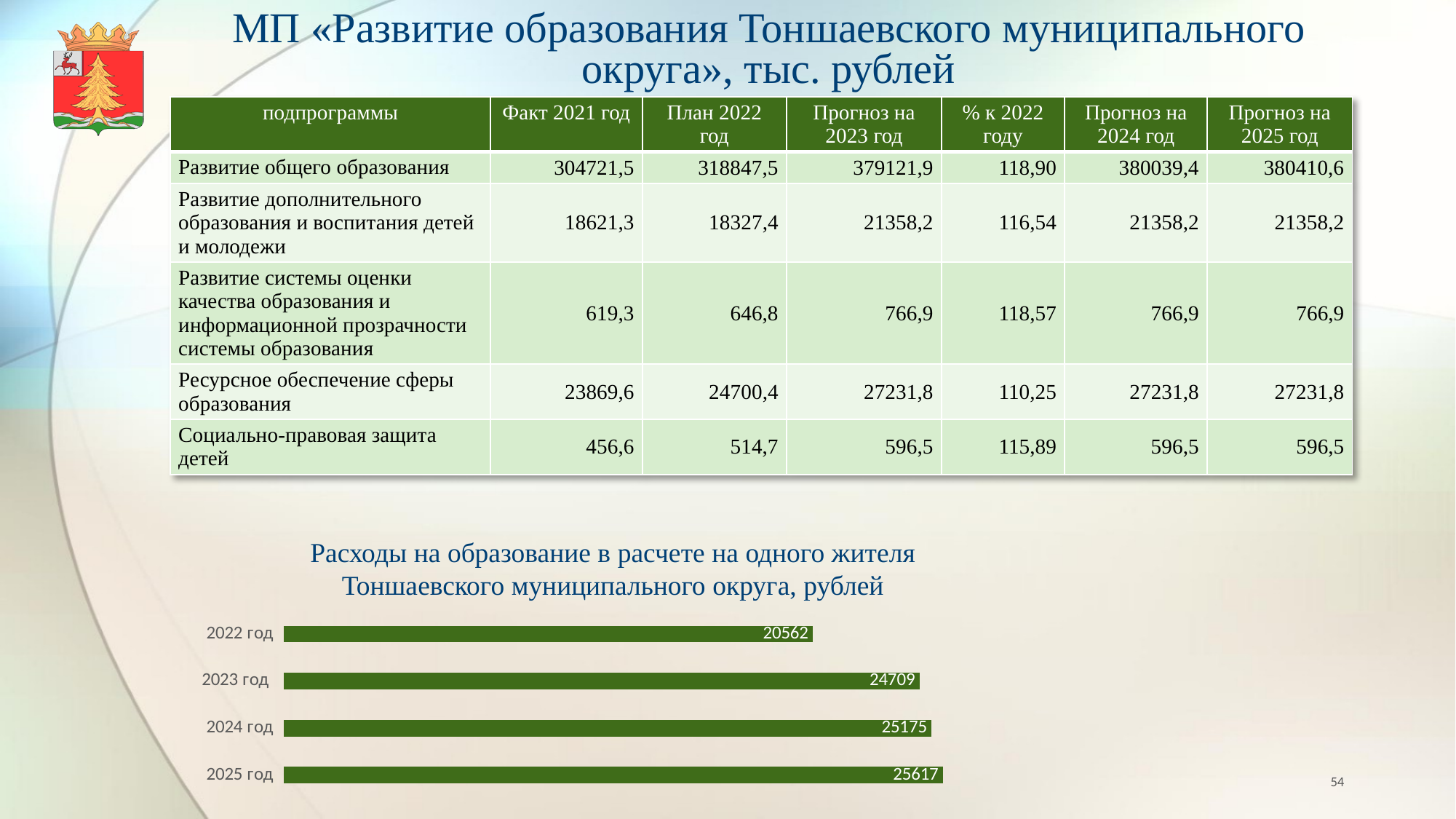
How many bars are shown in the bar chart? 4 What is the value for 2024 год in the bar chart? 25175 What is the value for 2025 год in the bar chart? 25617 What type of chart is shown at the bottom of the slide? bar chart Do the values in the bar chart rise or fall from 2022 год to 2025 год? rise Which year has the lowest value in the bar chart? 2022 год What is the difference between the values for 2023 год and 2022 год in the bar chart? 4147 Which is larger in the bar chart, the value for 2023 год or 2024 год? 2024 год What is the value for 2023 год in the bar chart? 24709 What is the value for 2022 год in the bar chart? 20562 What is the difference between the values for 2025 год and 2022 год in the bar chart? 5055 Which year has the highest value in the bar chart? 2025 год